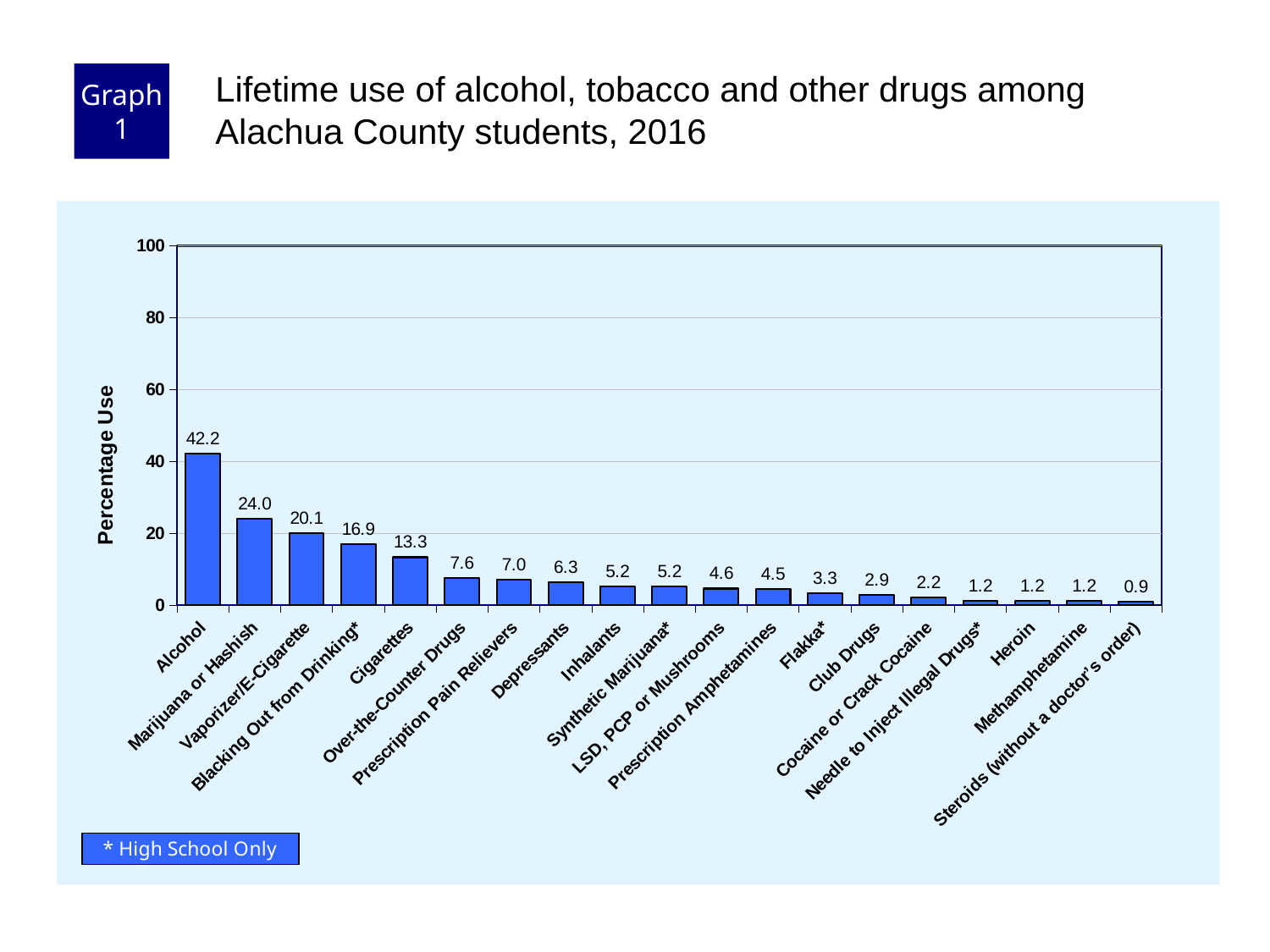
What is the percentage use for Flakka*? 3.3 How many categories are shown on the x axis? 19 Which has a higher percentage use, Over-the-Counter Drugs or Depressants? Over-the-Counter Drugs What kind of chart is shown on the slide? Bar chart Which category has the lowest percentage use? Steroids (without a doctor's order) Which category has the highest percentage use? Alcohol What is the label of the y axis? Percentage Use What is the percentage use for Vaporizer/E-Cigarette? 20.1 What is the percentage use for Cigarettes? 13.3 What is the difference in percentage use between Alcohol and Marijuana or Hashish? 18.2 Is the value for Marijuana or Hashish greater or less than 20? greater What is the percentage use for Alcohol? 42.2